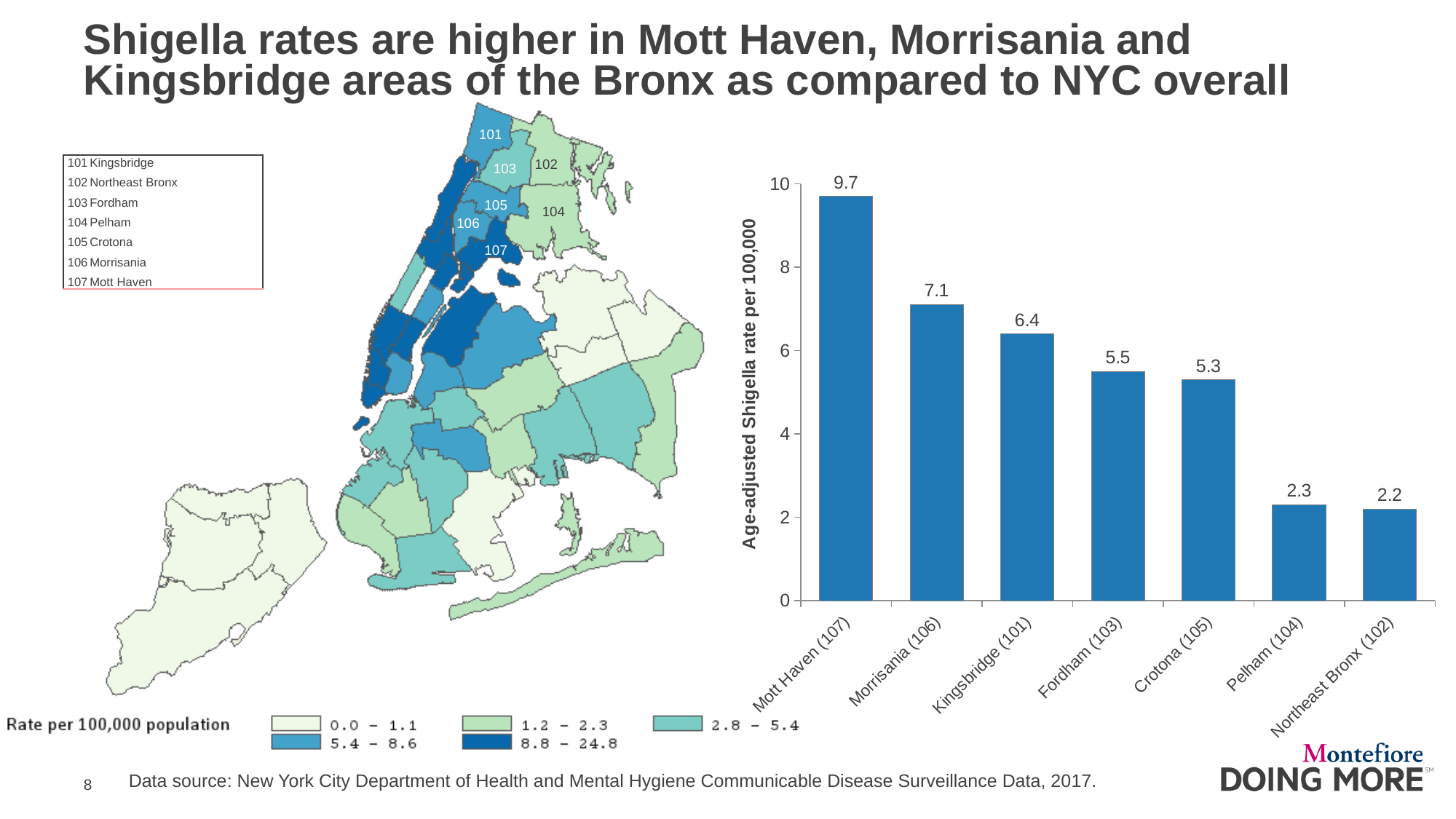
In the bar chart, is the value for Pelham (104) greater or less than 4? less What is the label of the vertical axis of the bar chart? Age-adjusted Shigella rate per 100,000 In the bar chart, what is the age-adjusted Shigella rate per 100,000 for Fordham (103)? 5.5 In the bar chart, do the values rise or fall from left to right along the x axis? fall In the bar chart, which neighborhood has the lowest age-adjusted Shigella rate? Northeast Bronx (102) In the bar chart, what is the difference between the Shigella rates for Mott Haven (107) and Morrisania (106)? 2.6 What kind of chart is shown on the right side of the slide? bar chart In the bar chart, which has a higher Shigella rate, Kingsbridge (101) or Crotona (105)? Kingsbridge (101) In the bar chart, which neighborhood has the highest age-adjusted Shigella rate? Mott Haven (107) In the bar chart, what is the age-adjusted Shigella rate per 100,000 for Northeast Bronx (102)? 2.2 In the bar chart, what is the age-adjusted Shigella rate per 100,000 for Mott Haven (107)? 9.7 How many neighborhoods are shown in the bar chart? 7